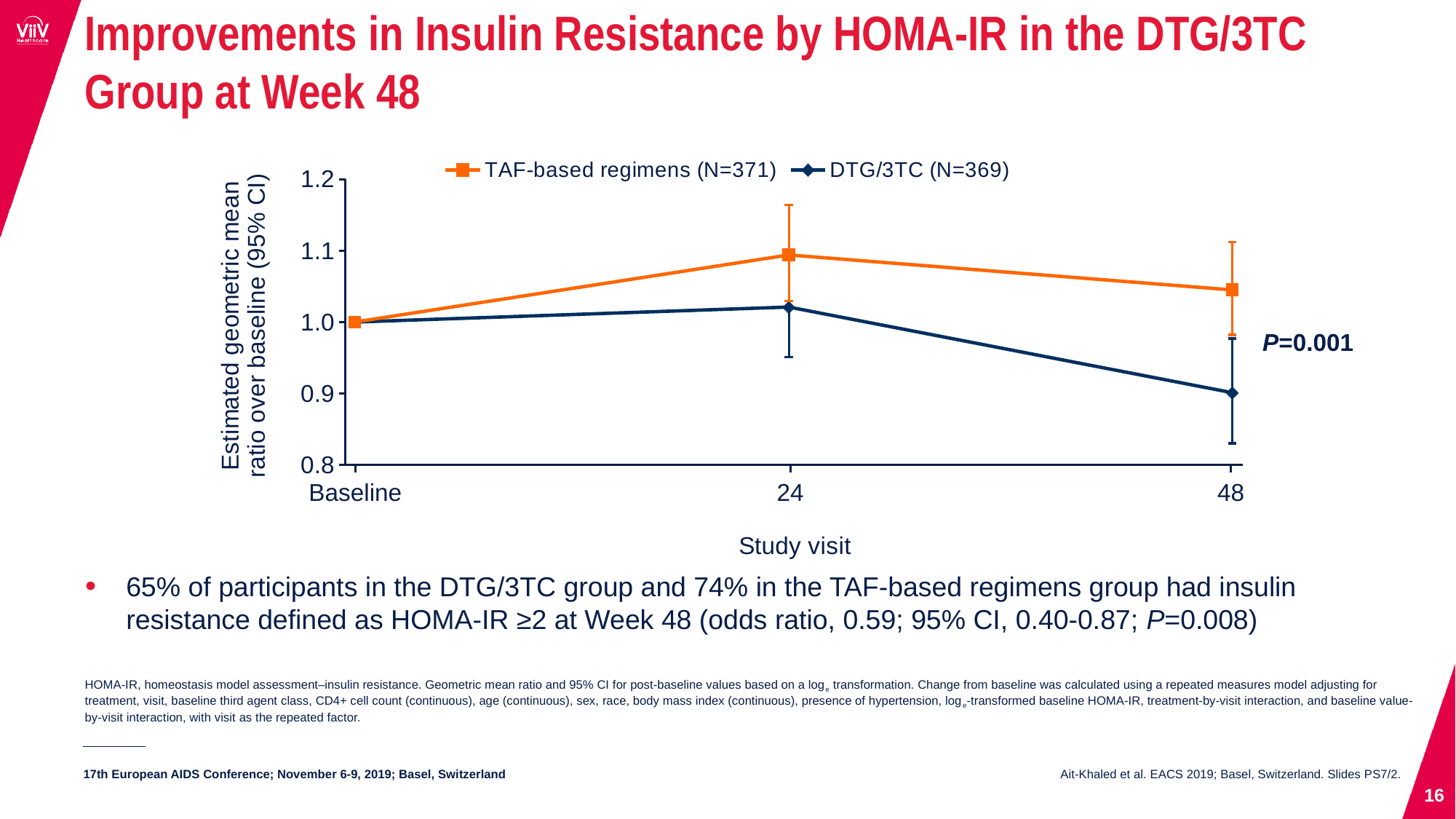
Which group has the higher value at week 48? TAF-based regimens (N=371) Does the DTG/3TC line rise or fall from week 24 to week 48? Fall How many series does the legend list? 2 Is the value for TAF-based regimens at week 24 greater or less than 1.0? greater What is the estimated geometric mean ratio for both groups at Baseline? 1.0 Which group has the lower value at week 24? DTG/3TC (N=369) What P value is shown next to the week 48 data points? P=0.001 What kind of chart is shown on the slide? Line chart Is the value for TAF-based regimens at week 48 greater or less than 1.0? greater How many study visits are plotted along the x axis? 3 What is the label of the x axis? Study visit Is the value for DTG/3TC at week 48 greater or less than 1.0? less